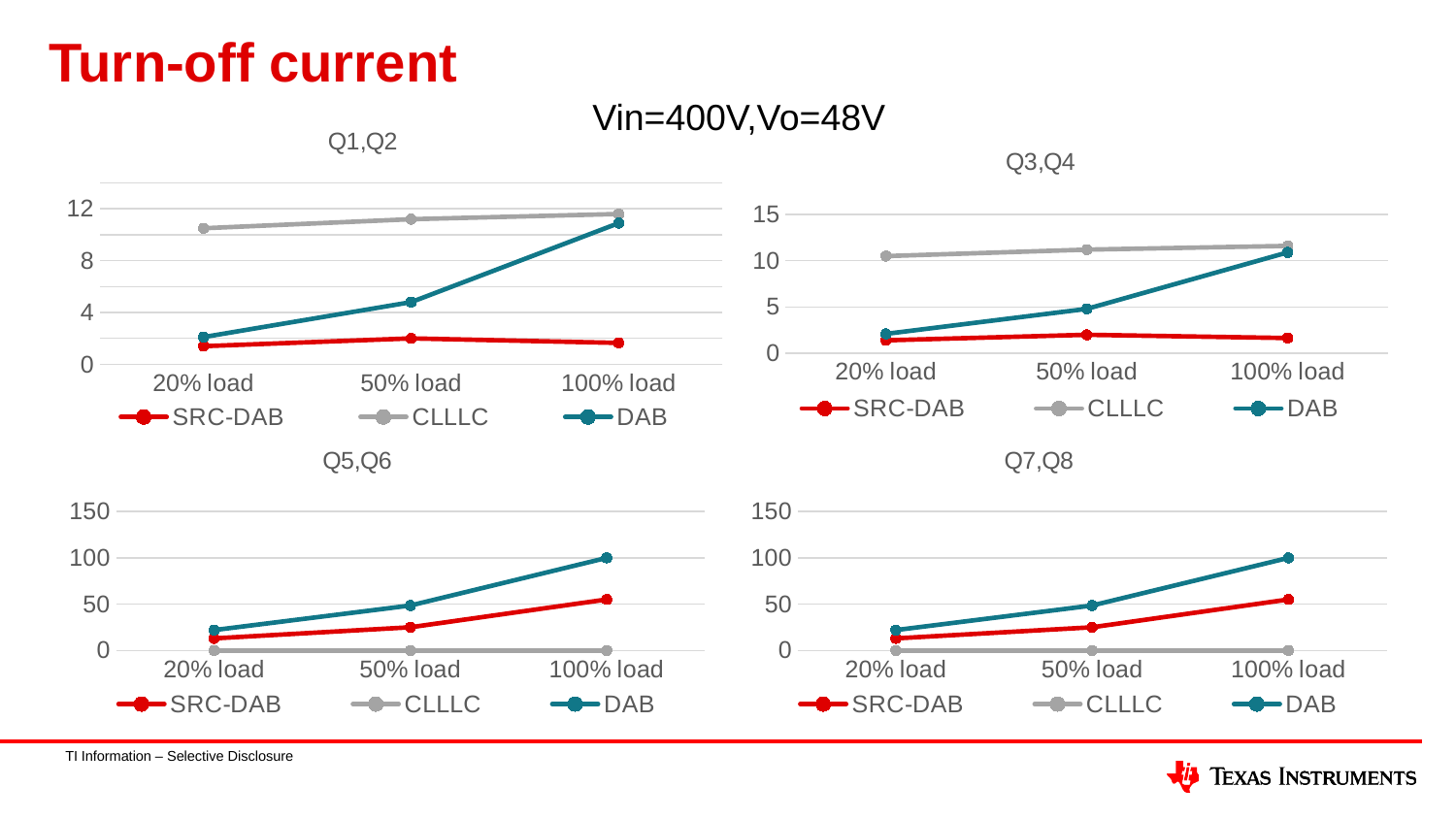
In the Q3,Q4 chart, which is larger at 100% load, CLLLC or SRC-DAB? CLLLC In the Q5,Q6 chart, do the DAB values rise or fall from 20% load to 100% load? rise In the Q1,Q2 chart, is the value for CLLLC at 20% load greater or less than 8? greater In the Q3,Q4 chart, which is larger at 50% load, DAB or SRC-DAB? DAB In the Q5,Q6 chart, how many load categories are shown on the x axis? 3 In the Q1,Q2 chart, is the value for DAB at 50% load greater or less than 8? less What operating condition is stated above the charts? Vin=400V,Vo=48V In the Q7,Q8 chart, which series has the lowest value at 50% load? CLLLC In the Q5,Q6 chart, is the value for DAB at 100% load greater or less than 50? greater What kind of chart is the Q1,Q2 chart? line chart In the Q1,Q2 chart, which series has the highest value at 20% load? CLLLC In the Q3,Q4 chart, how many series does the legend list? 3